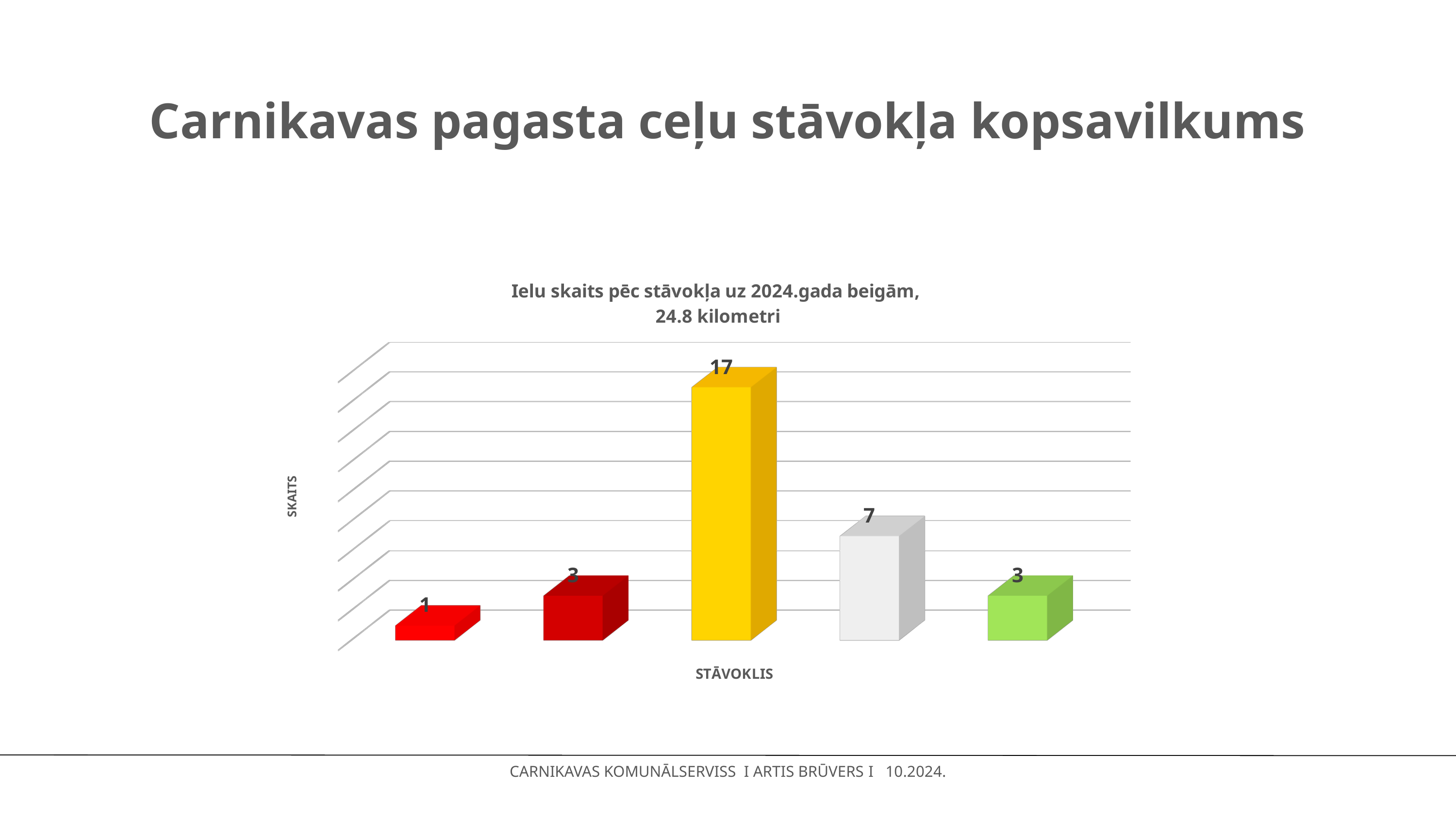
What is the value of the shortest bar (the first, bright red bar on the left)? 1 What is the value shown on the green bar (rightmost)? 3 What is the title of the chart? Ielu skaits pēc stāvokļa uz 2024.gada beigām, 24.8 kilometri What is the value shown on the grey bar (fourth from the left)? 7 Which is larger: the value of the grey bar or the value of the green bar? the grey bar What is the value of the tallest bar (the yellow bar in the middle)? 17 What is the difference between the yellow bar's value and the grey bar's value? 10 What type of chart is shown on the slide? bar chart What is the value shown on the dark red bar (second from the left)? 3 What is the label of the vertical axis? SKAITS What is the total of all five bar values in the chart? 31 How many bars are plotted in the chart? 5